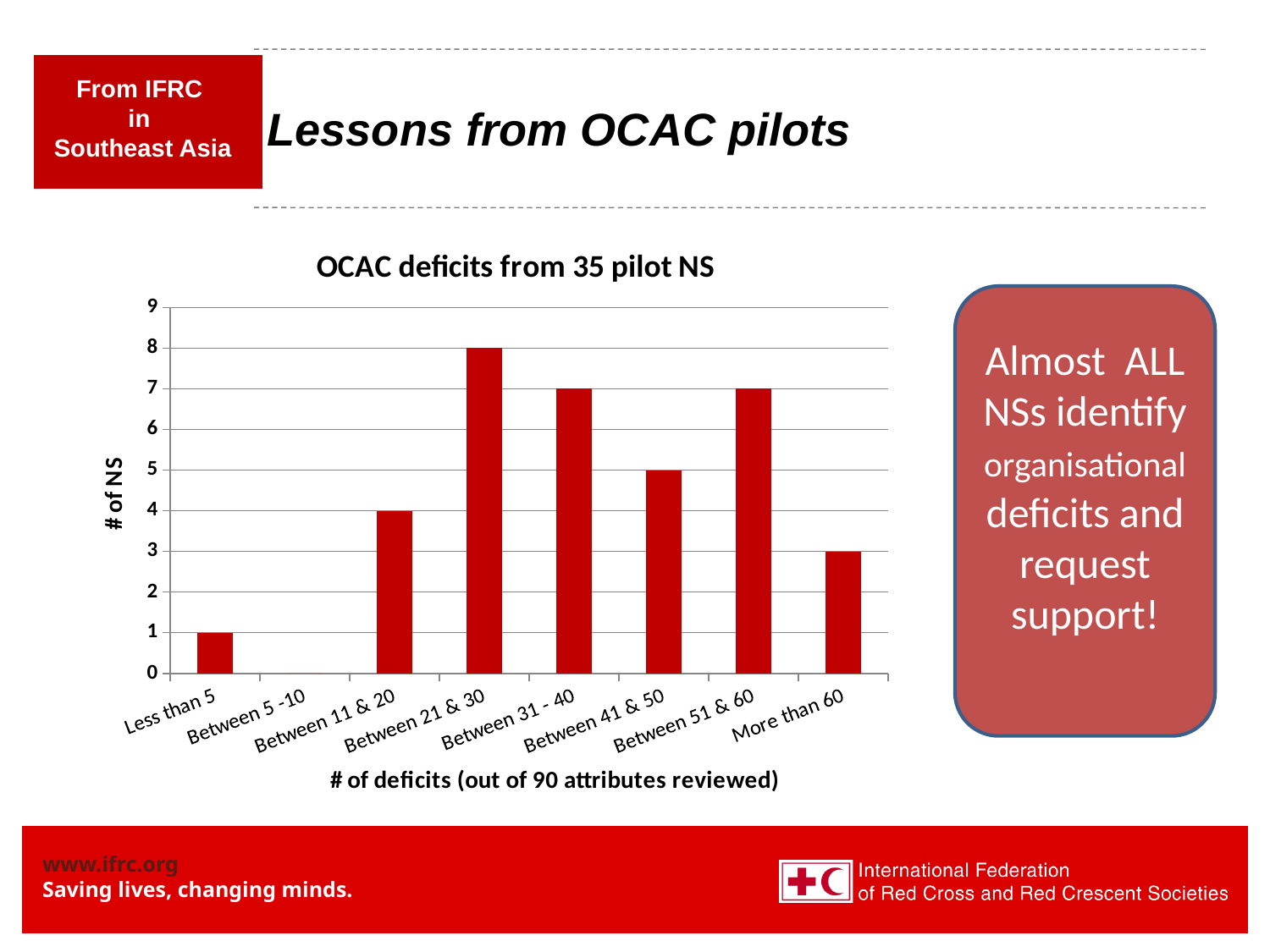
What type of chart is shown on the slide? bar chart Which category has the highest number of NS? Between 21 & 30 Which category has the lowest number of NS? Between 5 -10 What is the title of the chart? OCAC deficits from 35 pilot NS What is the difference in number of NS between 'Between 21 & 30' and 'Between 11 & 20'? 4 What is the number of NS for the 'More than 60' category? 3 How many categories are shown on the x axis of the chart? 8 What is the label of the y axis? # of NS What is the number of NS for the 'Less than 5' category? 1 What is the number of NS for the 'Between 21 & 30' category? 8 What is the number of NS for the 'Between 41 & 50' category? 5 Which has more NS: 'Between 31 - 40' or 'Between 41 & 50'? Between 31 - 40